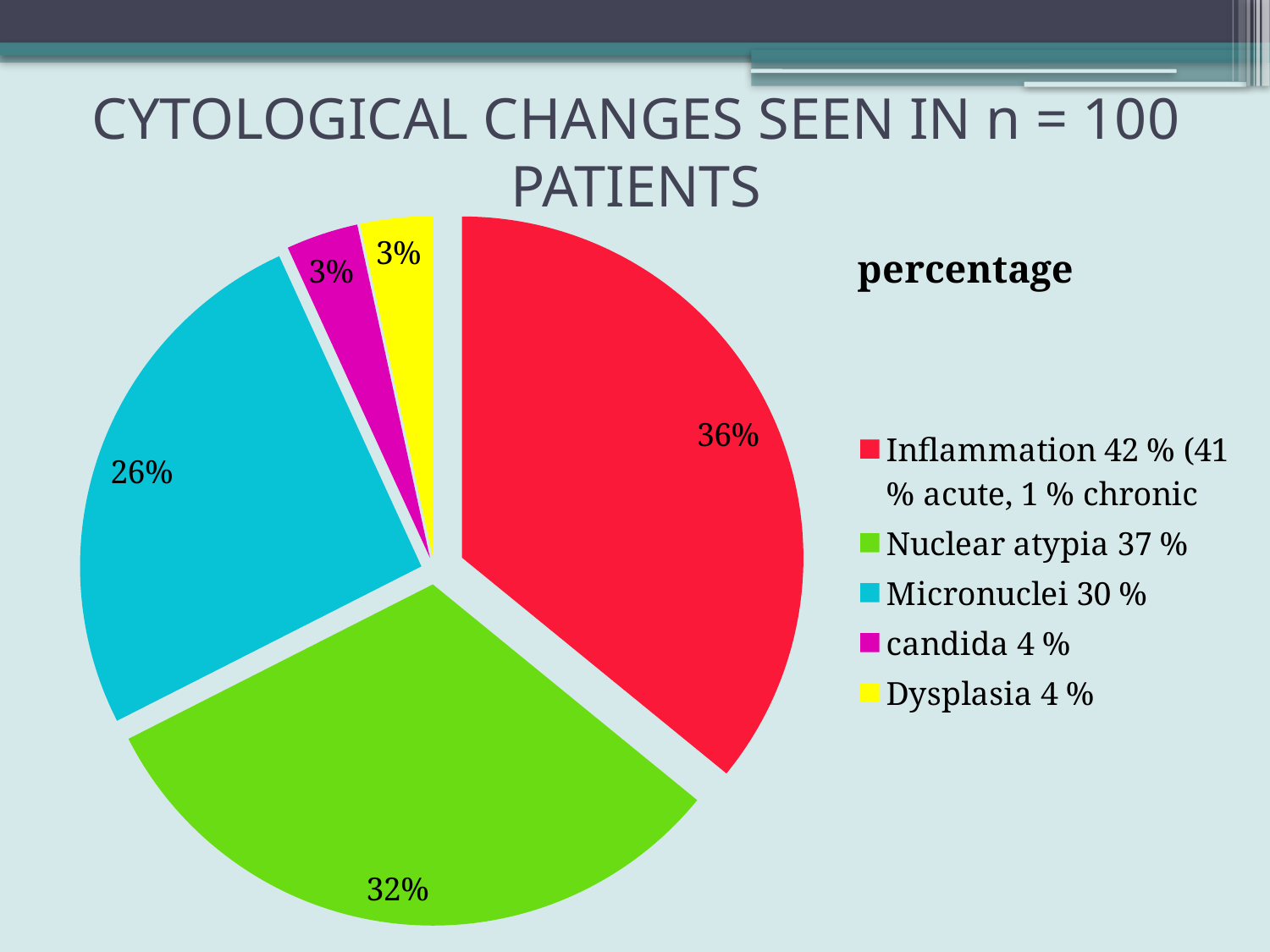
What is the difference between the Inflammation slice label and the Micronuclei slice label? 10% What kind of chart is shown on the slide? pie chart What percentage label is shown on the Dysplasia slice? 3% What colour is the Micronuclei slice? cyan What is the chart's title? percentage How many entries does the legend list? 5 How many slices does the pie chart have? 5 What percentage label is shown on the Inflammation slice? 36% Which category has the largest slice of the pie? Inflammation Which slice is larger, Nuclear atypia or Micronuclei? Nuclear atypia What percentage label is shown on the Nuclear atypia slice? 32% What percentage label is shown on the Micronuclei slice? 26%